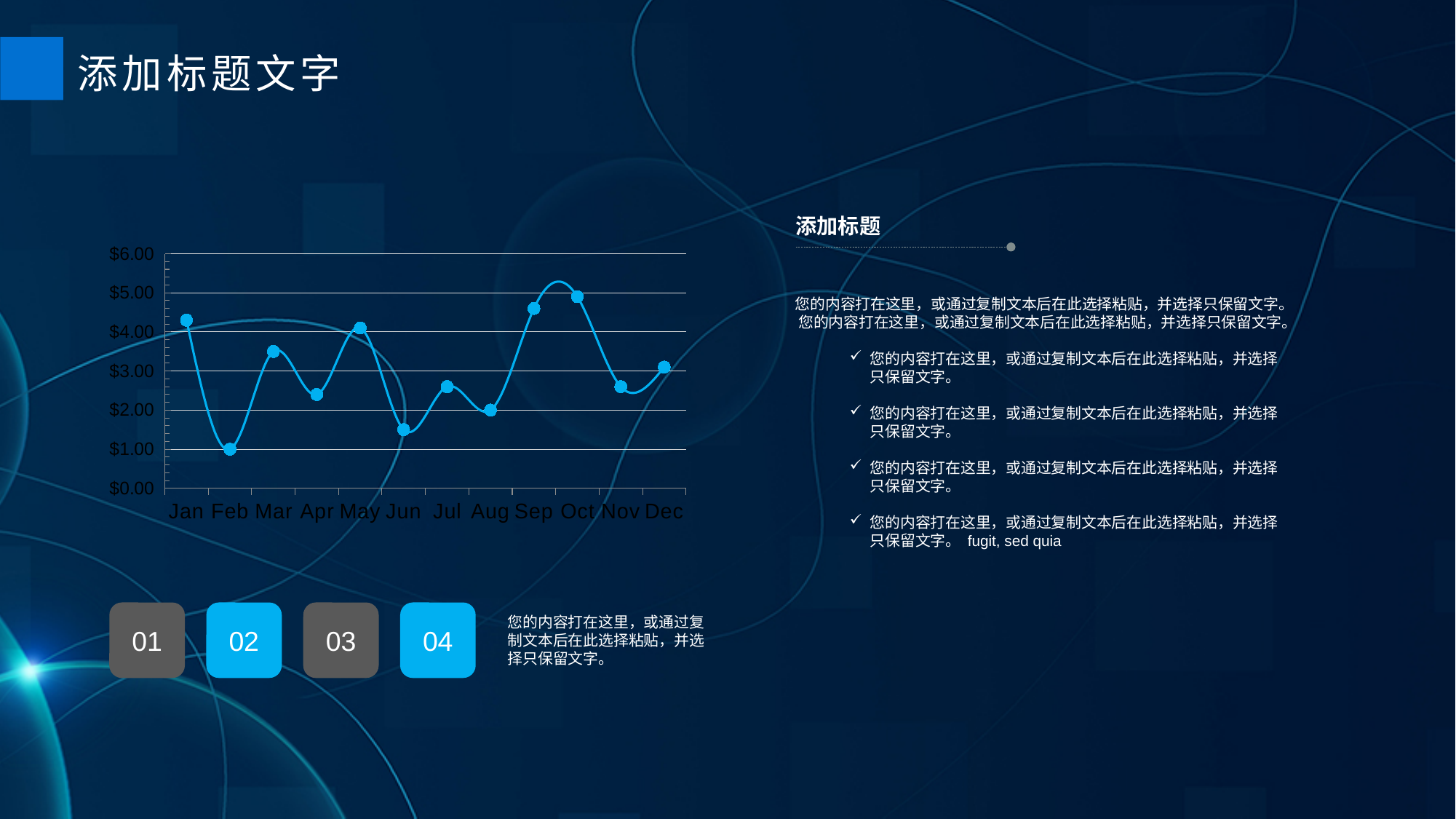
Which month has the highest value in the chart? Oct Does the value rise or fall from Oct to Nov? fall What is the value for Feb in the chart? $1.00 What kind of chart is shown on the slide? line chart Is the value for Sep greater or less than $4.00? greater Which is larger, the value for Mar or the value for Apr? Mar What is the highest value shown on the chart's y axis? $6.00 Is the value for Jun greater or less than $2.00? less Which month has the lowest value in the chart? Feb Is the value for Jan greater or less than $4.00? greater How many months are plotted along the x axis of the chart? 12